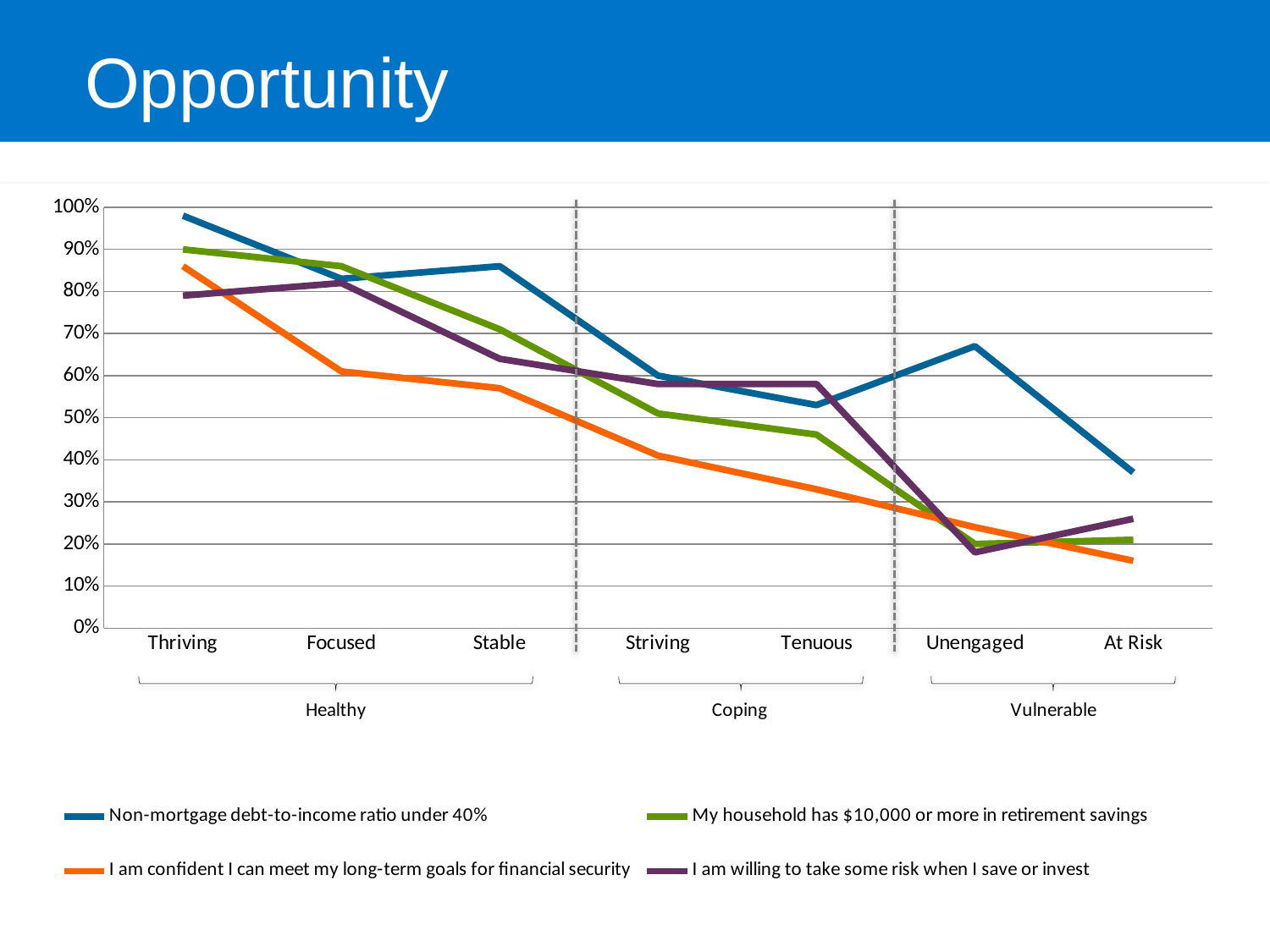
What kind of chart is shown on the slide? line chart At Unengaged, which series is larger: 'Non-mortgage debt-to-income ratio under 40%' or 'My household has $10,000 or more in retirement savings'? Non-mortgage debt-to-income ratio under 40% For the series 'I am confident I can meet my long-term goals for financial security', which category has the lowest value? At Risk Is the value for 'I am confident I can meet my long-term goals for financial security' at At Risk greater or less than 20%? less How many series does the legend list? 4 Does the series 'I am confident I can meet my long-term goals for financial security' rise or fall from Thriving to At Risk? fall Is the value for 'Non-mortgage debt-to-income ratio under 40%' at Thriving greater or less than 90%? greater How many categories are shown along the x axis? 7 For the series 'Non-mortgage debt-to-income ratio under 40%', which category has the highest value? Thriving At Thriving, which series is larger: 'Non-mortgage debt-to-income ratio under 40%' or 'I am willing to take some risk when I save or invest'? Non-mortgage debt-to-income ratio under 40% What are the three group labels shown beneath the x axis categories? Healthy, Coping, Vulnerable Is the value for 'My household has $10,000 or more in retirement savings' at Tenuous greater or less than 50%? less